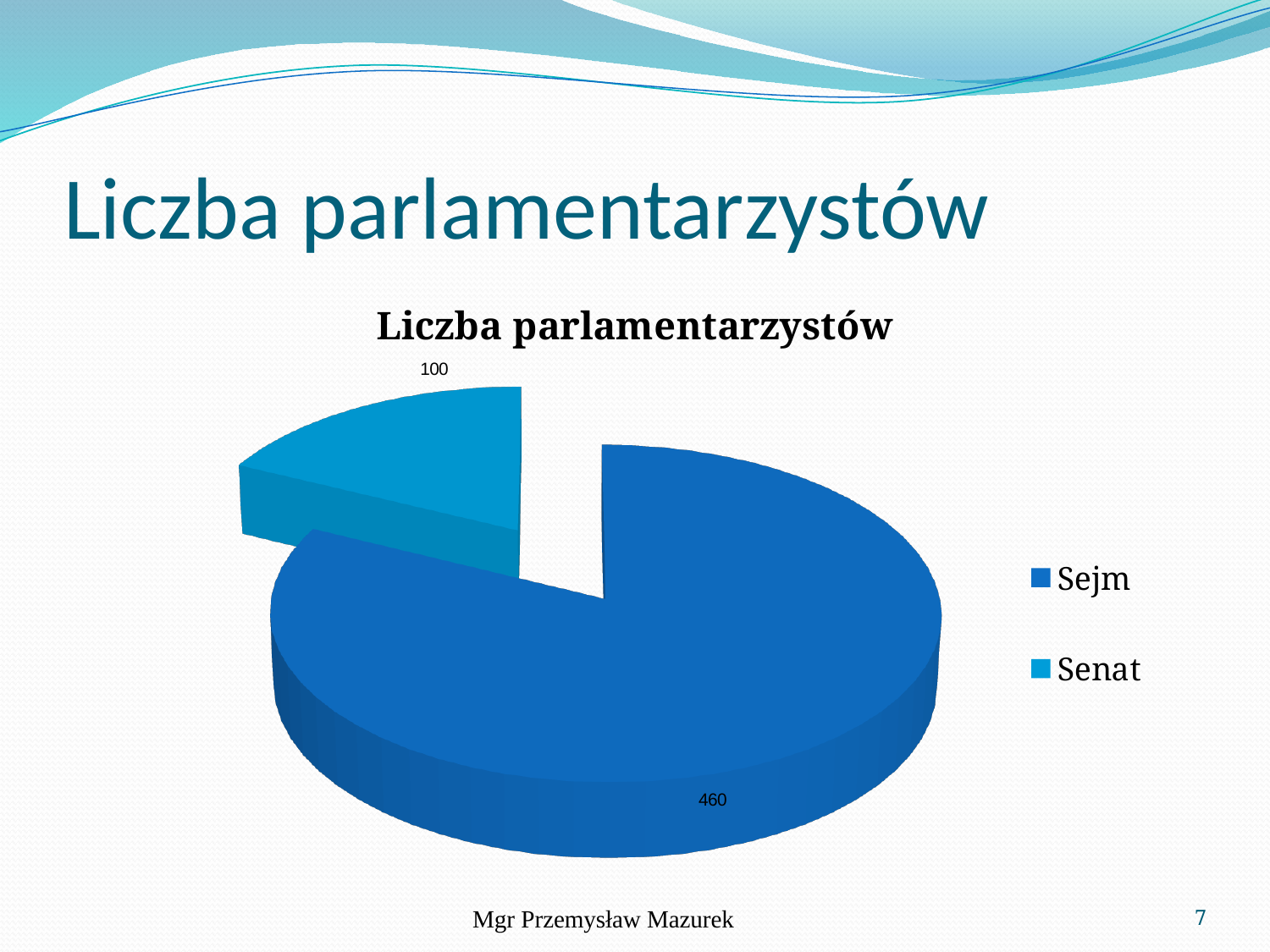
What is the value for Senat? 100 What kind of chart is shown on the slide? pie chart What is the difference between the values for Sejm and Senat? 360 What is the title of the chart? Liczba parlamentarzystów Which slice is pulled out from the pie? Senat Which category has the smallest slice? Senat Which is larger, the value for Sejm or the value for Senat? Sejm What is the value for Sejm? 460 How many categories does the pie chart show? 2 What is the total of all slices in the pie chart? 560 Which category has the largest slice? Sejm How many entries does the legend list? 2